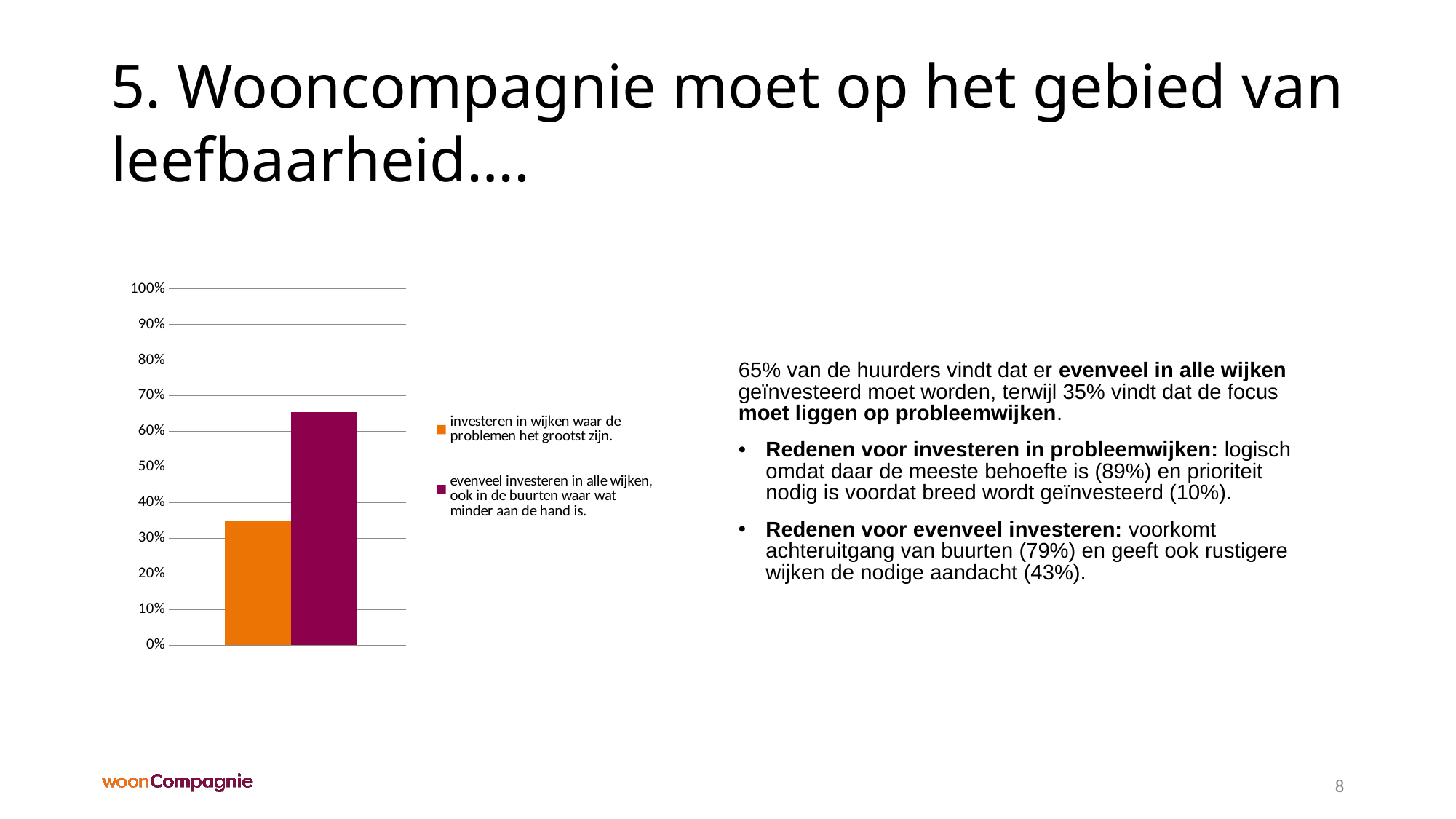
According to the slide, what share of tenants thinks there should be equal investment in all neighbourhoods ('evenveel in alle wijken')? 65% According to the slide, what share of tenants thinks the focus should be on problem neighbourhoods ('probleemwijken')? 35% What kind of chart is shown on the slide? bar chart How many bars are plotted in the chart? 2 How many series does the chart legend list? 2 What colour is the bar for 'evenveel investeren in alle wijken'? purple Is the value for 'evenveel investeren in alle wijken' greater or less than 60%? greater Is the value for 'investeren in wijken waar de problemen het grootst zijn' greater or less than 40%? less Which series has the taller bar: 'investeren in wijken waar de problemen het grootst zijn' or 'evenveel investeren in alle wijken'? evenveel investeren in alle wijken Which series has the shorter bar in the chart? investeren in wijken waar de problemen het grootst zijn Is the value for 'evenveel investeren in alle wijken' greater or less than 70%? less